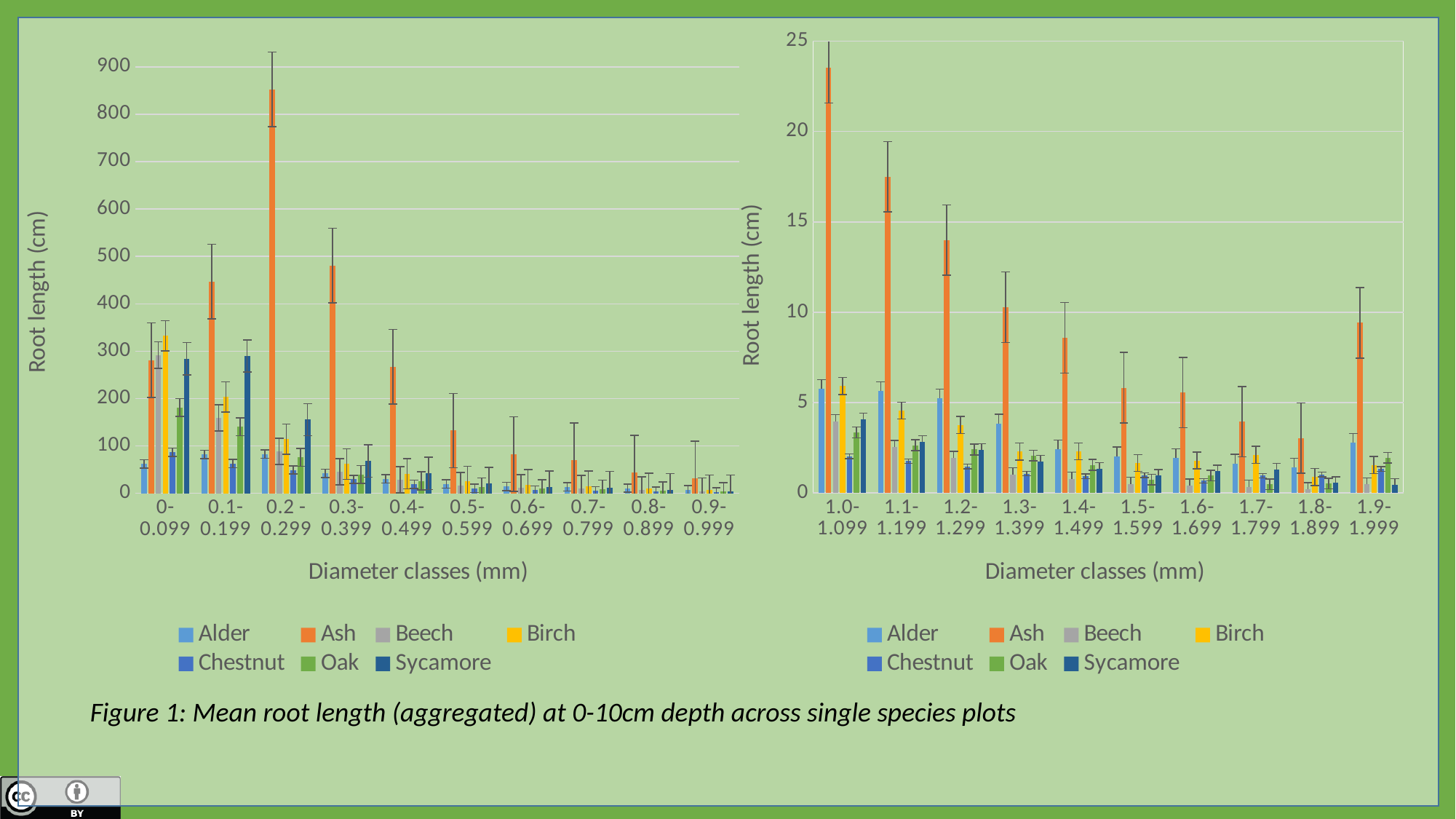
In the right chart, which diameter class has the tallest Ash bar? 1.0-1.099 In the right chart, is the Ash value for the 1.0-1.099 diameter class greater or less than 20? greater In the right chart, which diameter class has the larger Ash value: 1.0-1.099 or 1.1-1.199? 1.0-1.099 What kind of chart is the left chart on the slide? Bar chart In the left chart, is the Ash value for the 0.2-0.299 diameter class greater or less than 800? greater In the left chart, which diameter class has the tallest Ash bar? 0.2-0.299 In the left chart, is the Ash value for the 0.1-0.199 diameter class greater or less than 400? greater What is the y-axis title of the left chart? Root length (cm) How many series does the legend of the right chart list? 7 In the left chart, which is larger for the 0.2-0.299 diameter class: the Ash bar or the Alder bar? Ash How many diameter classes are shown on the x axis of the left chart? 10